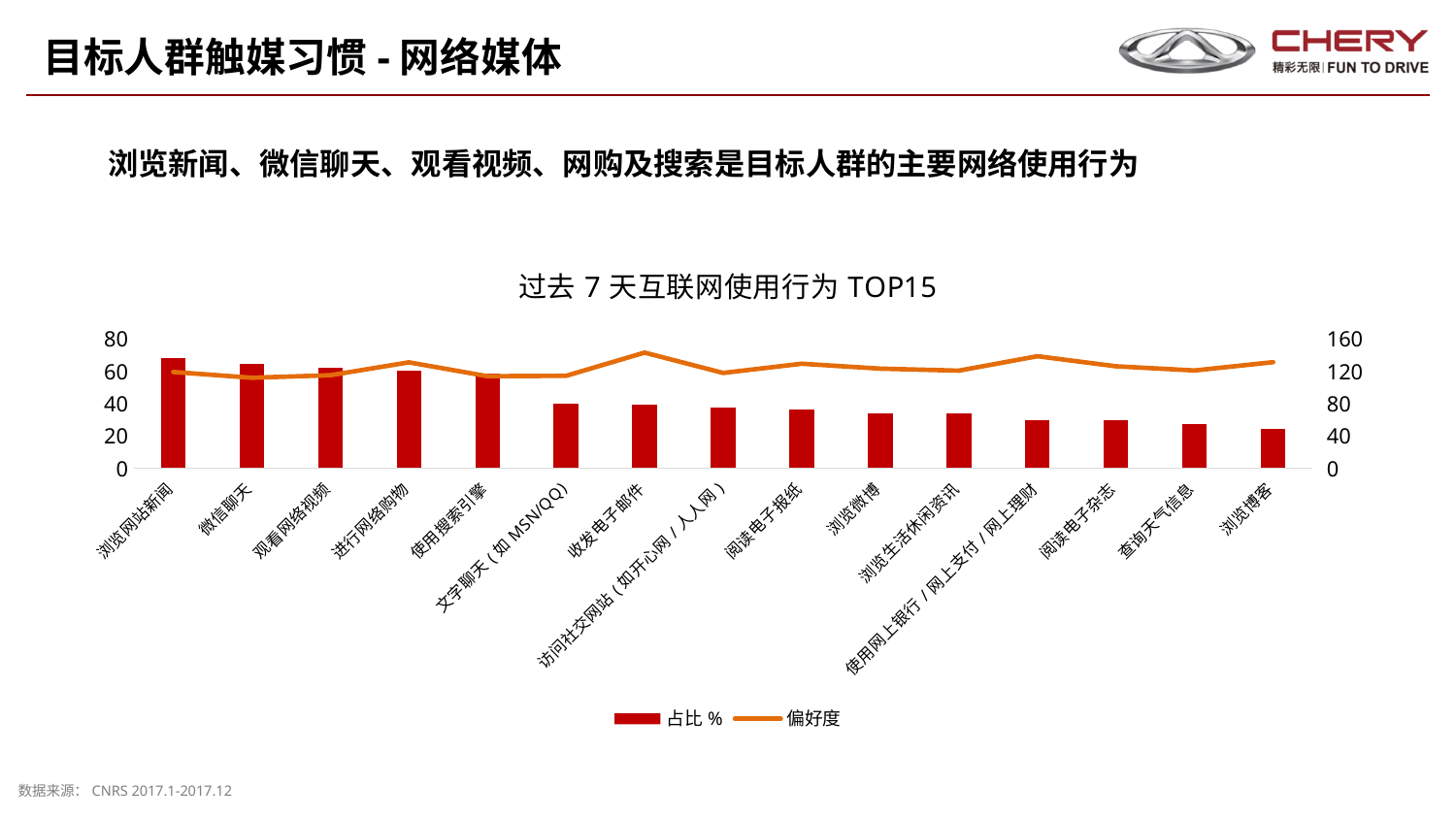
How many categories are plotted along the x axis of the chart? 15 What is the title of the chart? 过去 7 天互联网使用行为 TOP15 How many series does the chart legend list? 2 Is the 占比 % value for 文字聊天（如 MSN/QQ） greater or less than 60? less What kind of chart is shown on the slide? A combined bar and line chart Is the 占比 % value for 浏览博客 greater or less than 40? less Is the 占比 % value for 浏览网站新闻 greater or less than 60? greater Do the 占比 % bars generally rise or fall from left to right along the x axis? fall Which series is drawn as the orange line in the chart? 偏好度 Which category has the lowest 占比 % bar? 浏览博客 Which category has the highest 占比 % bar? 浏览网站新闻 Which has a larger 占比 % bar, 微信聊天 or 浏览博客? 微信聊天